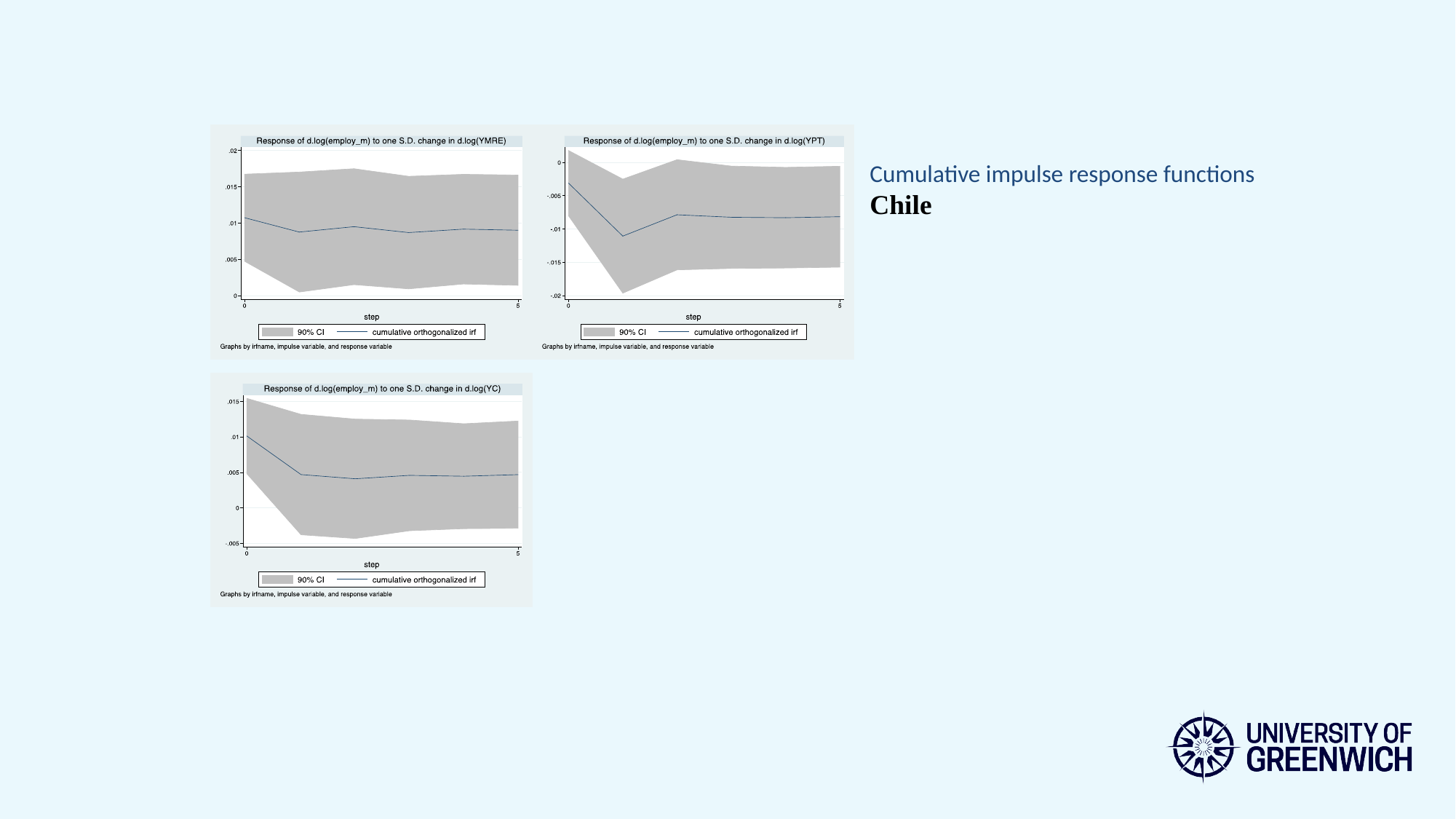
In the 'Response of d.log(employ_m) to one S.D. change in d.log(YPT)' chart, what is the label of the x axis? step In the 'Response of d.log(employ_m) to one S.D. change in d.log(YC)' chart, how many entries does the legend list? 2 In the 'Response of d.log(employ_m) to one S.D. change in d.log(YC)' chart, is the cumulative orthogonalized irf value at step 1 greater or less than .01? less In the 'Response of d.log(employ_m) to one S.D. change in d.log(YC)' chart, is the cumulative orthogonalized irf value at step 0 greater or less than .005? greater How many charts are shown on the slide? 3 What confidence level does the shaded band in the legend of each chart represent? 90% CI In the 'Response of d.log(employ_m) to one S.D. change in d.log(YPT)' chart, does the cumulative orthogonalized irf line rise or fall from step 0 to step 1? fall In the 'Response of d.log(employ_m) to one S.D. change in d.log(YPT)' chart, is the cumulative orthogonalized irf value at step 0 greater or less than -.005? greater In the 'Response of d.log(employ_m) to one S.D. change in d.log(YC)' chart, does the cumulative orthogonalized irf line rise or fall from step 0 to step 1? fall What kind of chart is the 'Response of d.log(employ_m) to one S.D. change in d.log(YMRE)' chart? line chart